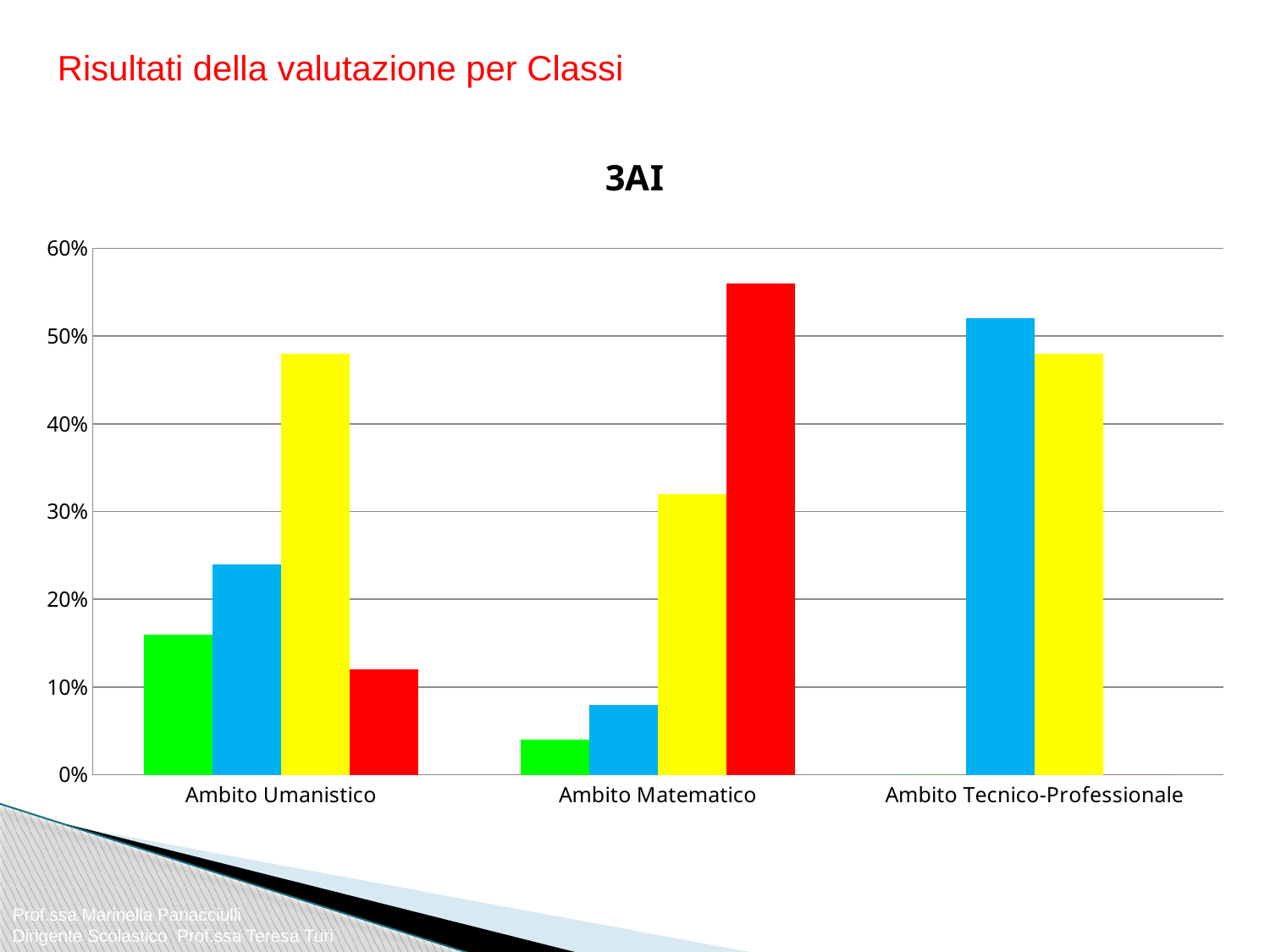
In Ambito Umanistico, which is larger: the yellow bar or the blue bar? the yellow bar Is the value of the yellow bar for Ambito Umanistico greater or less than 40%? greater Is the value of the red bar for Ambito Matematico greater or less than 50%? greater Is the value of the blue bar for Ambito Umanistico greater or less than 20%? greater In Ambito Tecnico-Professionale, which is larger: the blue bar or the yellow bar? the blue bar How many categories are shown on the x axis? 3 In Ambito Matematico, which coloured bar is the lowest? the green bar What is the title of the chart? 3AI Which category contains the tallest bar in the chart? Ambito Matematico How many bars are plotted for Ambito Tecnico-Professionale? 2 What kind of chart is shown on the slide? bar chart